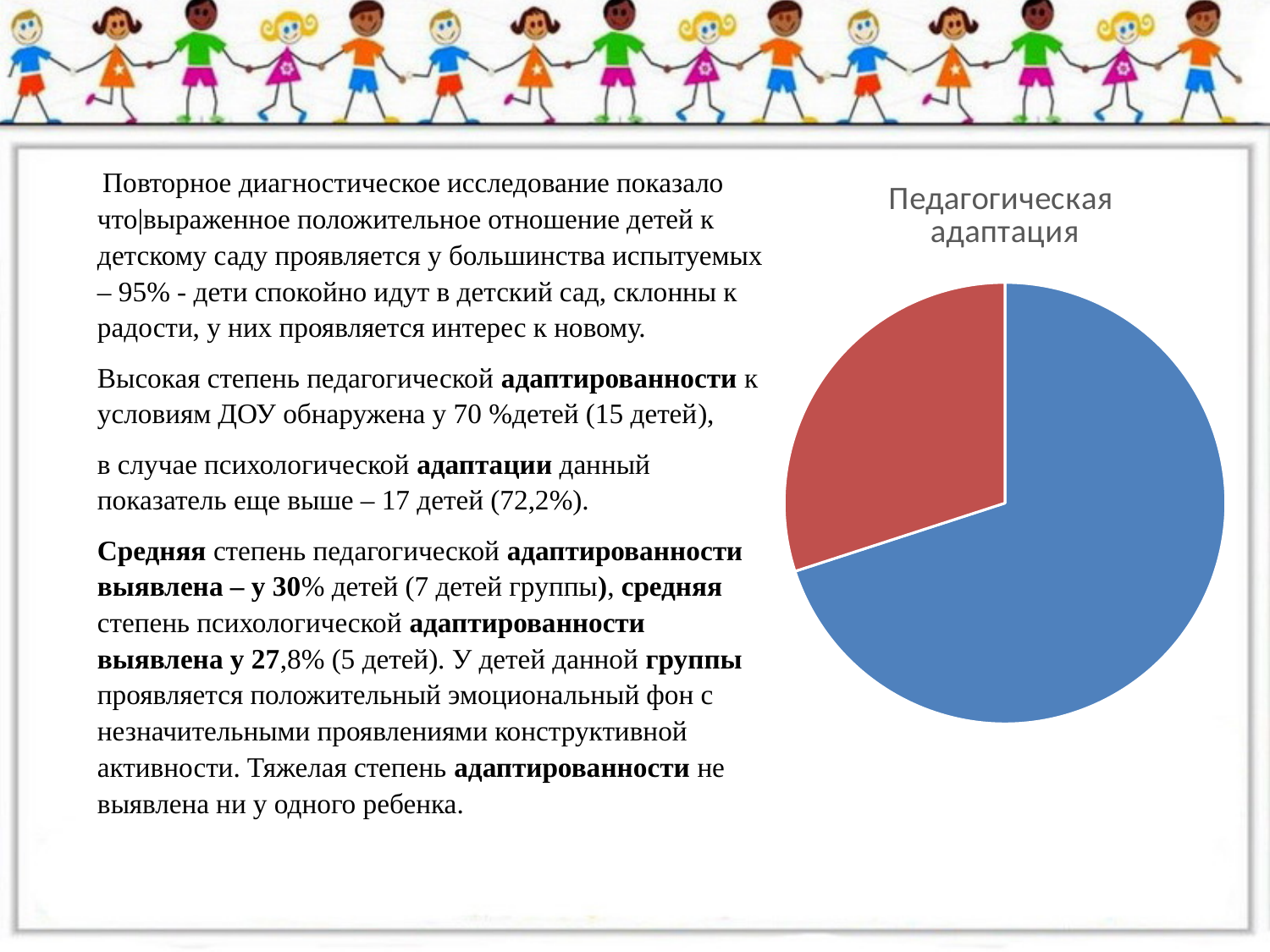
Which colour slice is the largest in the pie chart? blue Which colour slice is the smallest in the pie chart? red What is the title of the chart? Педагогическая адаптация Which slice of the pie chart is larger, the blue one or the red one? blue Does the blue slice cover more or less than half of the pie? more What kind of chart is shown on the slide? pie chart How many slices does the pie chart have? 2 What two colours are used for the slices of the pie chart? blue and red Does the red slice cover more or less than half of the pie? less